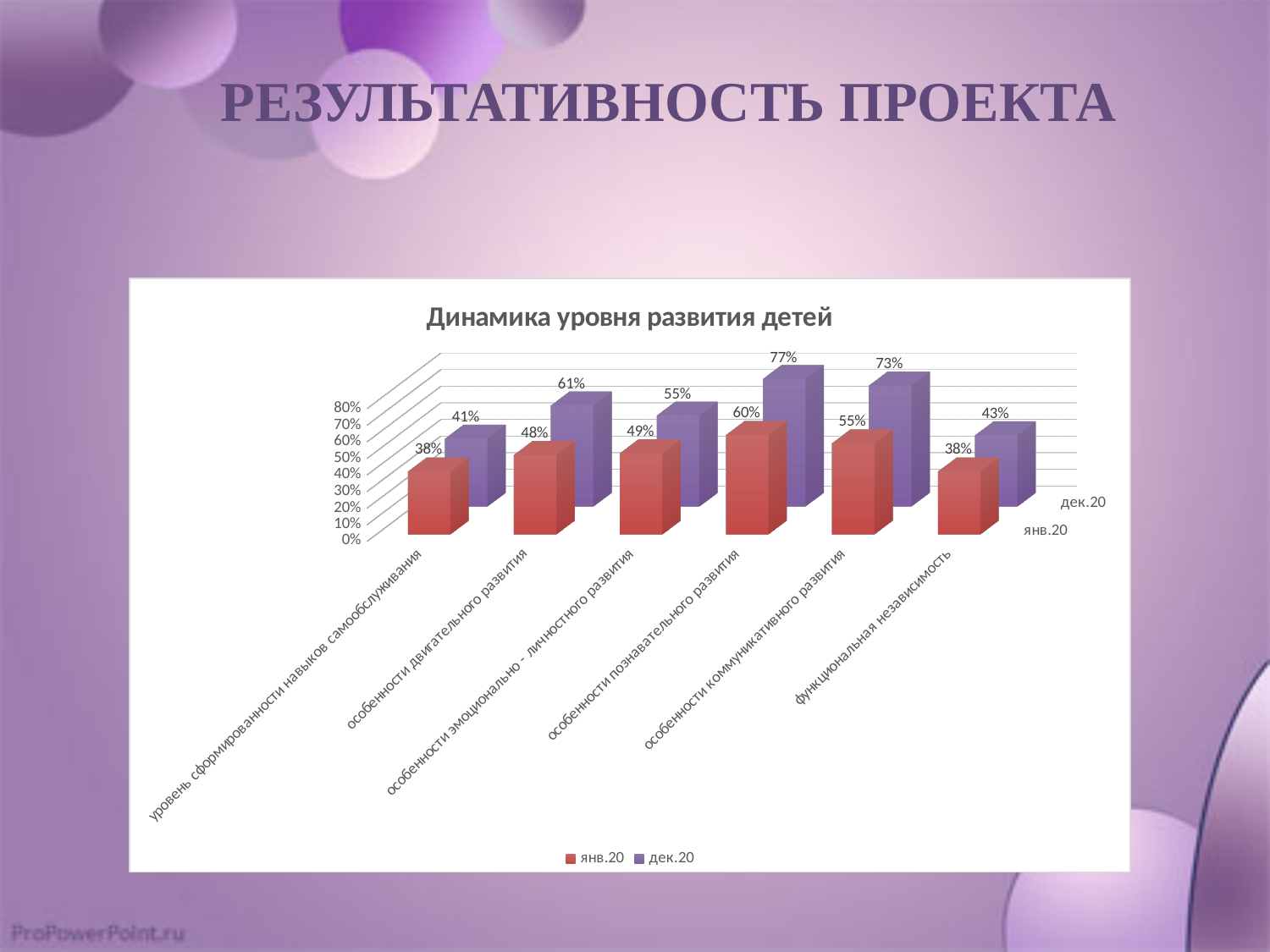
What is the title of the chart? Динамика уровня развития детей Which colour represents the янв.20 series? red What is the difference between the дек.20 and янв.20 values for особенности коммуникативного развития? 18% What is the value for особенности двигательного развития in the янв.20 series? 48% Which category has the lowest value in the дек.20 series? уровень сформированности навыков самообслуживания Which category has the highest value in the дек.20 series? особенности познавательного развития What is the value for особенности познавательного развития in the дек.20 series? 77% What kind of chart is shown on the slide? bar chart How many categories are shown on the x axis? 6 Which is larger: the янв.20 value for особенности познавательного развития or the янв.20 value for особенности коммуникативного развития? особенности познавательного развития What is the value for функциональная независимость in the дек.20 series? 43% How many series does the legend list? 2